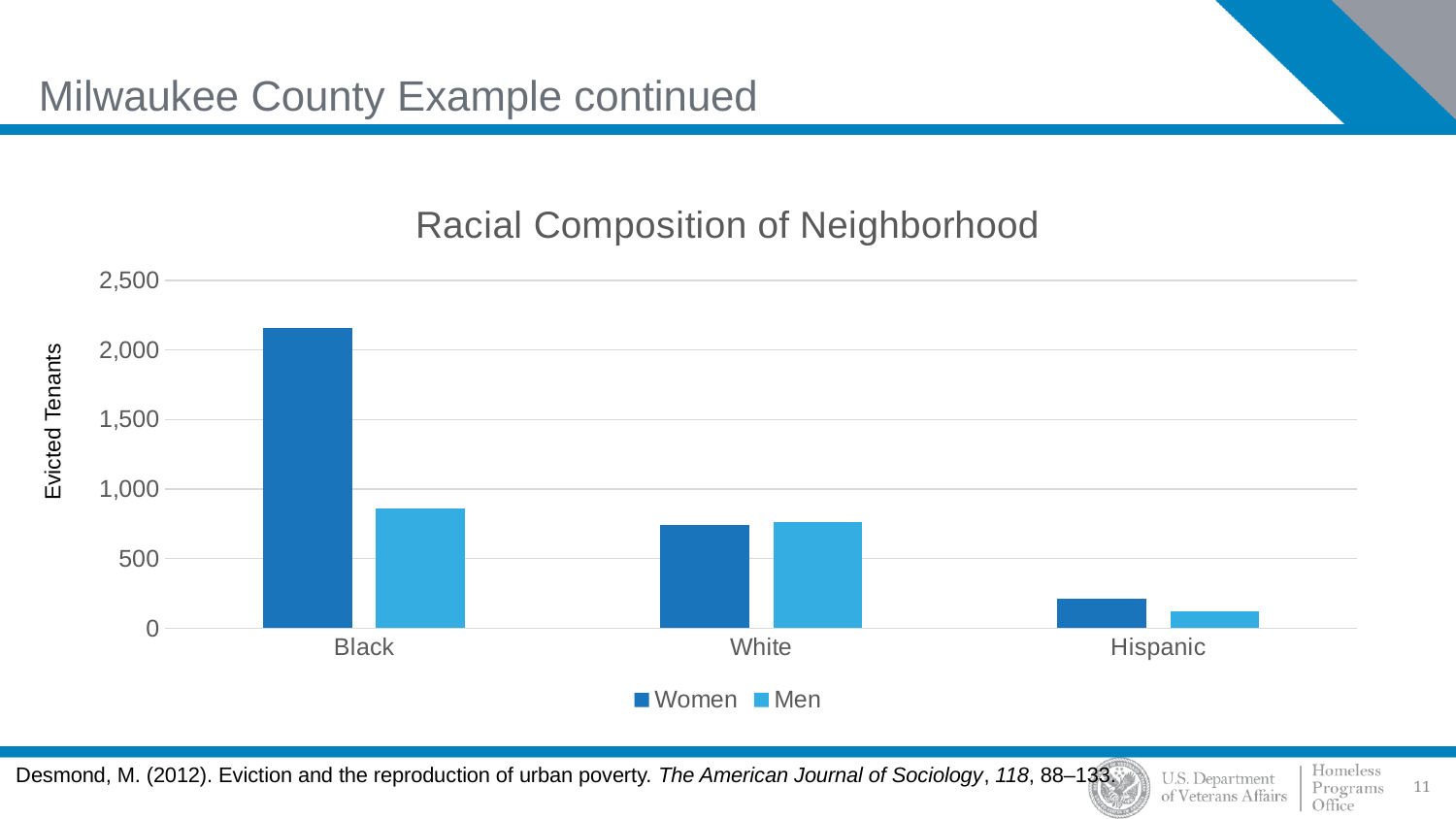
How many categories are shown on the x axis? 3 In the Black category, which is larger, the value for Women or the value for Men? Women Which category has the highest value for Men? Black What is the title of the chart? Racial Composition of Neighborhood Is the value for Men in the Black category greater or less than 1,000? less What kind of chart is shown on the slide? bar chart Which category has the lowest value for Women? Hispanic How many series does the legend list? 2 Which category has the highest value for Women? Black Is the value for Women in the Black category greater or less than 2,000? greater Is the value for Women in the White category greater or less than 500? greater Which category has the lowest value for Men? Hispanic